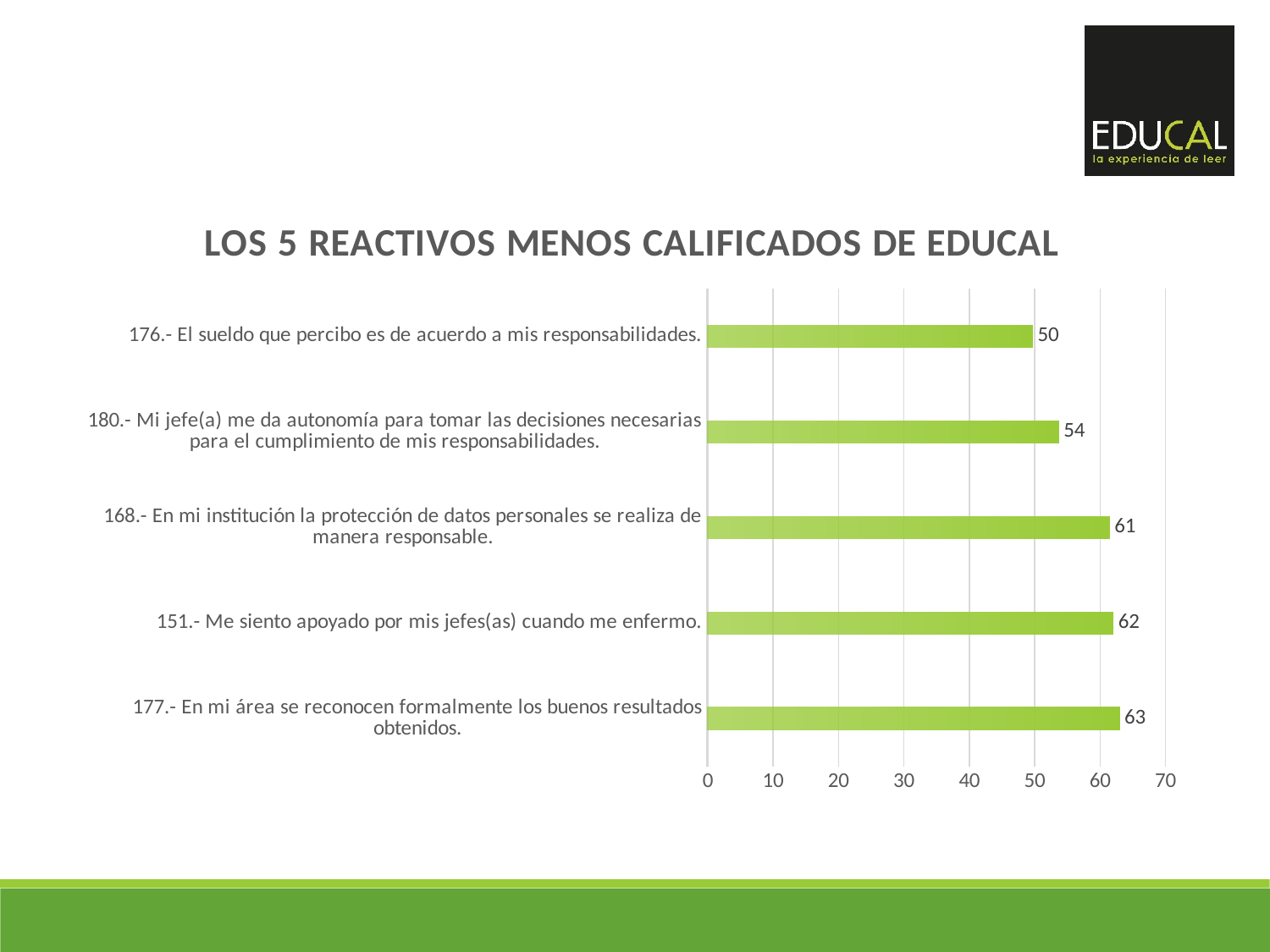
What is the value for reactivo 180 (Mi jefe(a) me da autonomía para tomar las decisiones necesarias)? 54 What kind of chart is shown on the slide? Bar chart What is the difference between the values for reactivo 177 and reactivo 176? 13 Which reactivo has the lowest value? 176.- El sueldo que percibo es de acuerdo a mis responsabilidades. What is the value for reactivo 168 (En mi institución la protección de datos personales se realiza de manera responsable)? 61 Which has a larger value, reactivo 180 or reactivo 168? 168.- En mi institución la protección de datos personales se realiza de manera responsable. How many reactivos are shown in the chart? 5 What is the value for reactivo 176 (El sueldo que percibo es de acuerdo a mis responsabilidades)? 50 Which reactivo has the highest value? 177.- En mi área se reconocen formalmente los buenos resultados obtenidos. What is the value for reactivo 151 (Me siento apoyado por mis jefes(as) cuando me enfermo)? 62 What is the value for reactivo 177 (En mi área se reconocen formalmente los buenos resultados obtenidos)? 63 What is the title of the chart? LOS 5 REACTIVOS MENOS CALIFICADOS DE EDUCAL